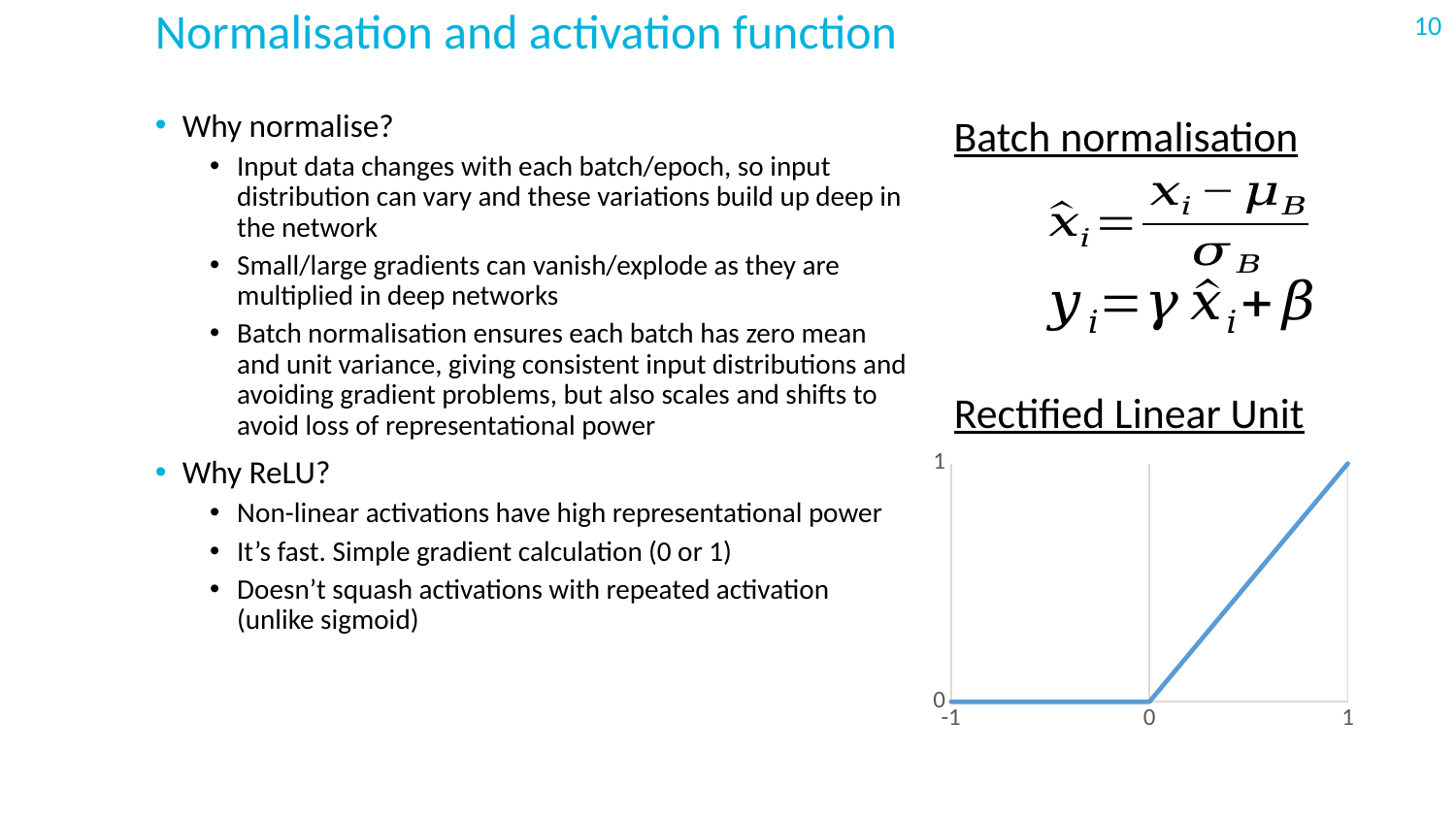
In the Rectified Linear Unit chart, what is the difference between the value at x = 1 and the value at x = 0? 1 In the Rectified Linear Unit chart, what is the leftmost value shown on the x axis? -1 In the Rectified Linear Unit chart, does the line rise, fall or stay flat between x = -1 and x = 0? stay flat In the Rectified Linear Unit chart, at which x value does the line reach its highest point? 1 In the Rectified Linear Unit chart, does the line rise, fall or stay flat between x = 0 and x = 1? rise What kind of chart is shown under the heading "Rectified Linear Unit"? line chart In the Rectified Linear Unit chart, what is the value of the line at x = -1? 0 In the Rectified Linear Unit chart, what is the value of the line at x = 0? 0 In the Rectified Linear Unit chart, which is larger: the value at x = 1 or the value at x = -1? x = 1 In the Rectified Linear Unit chart, what is the value of the line at x = 1? 1 In the Rectified Linear Unit chart, what is the lowest value shown on the y axis? 0